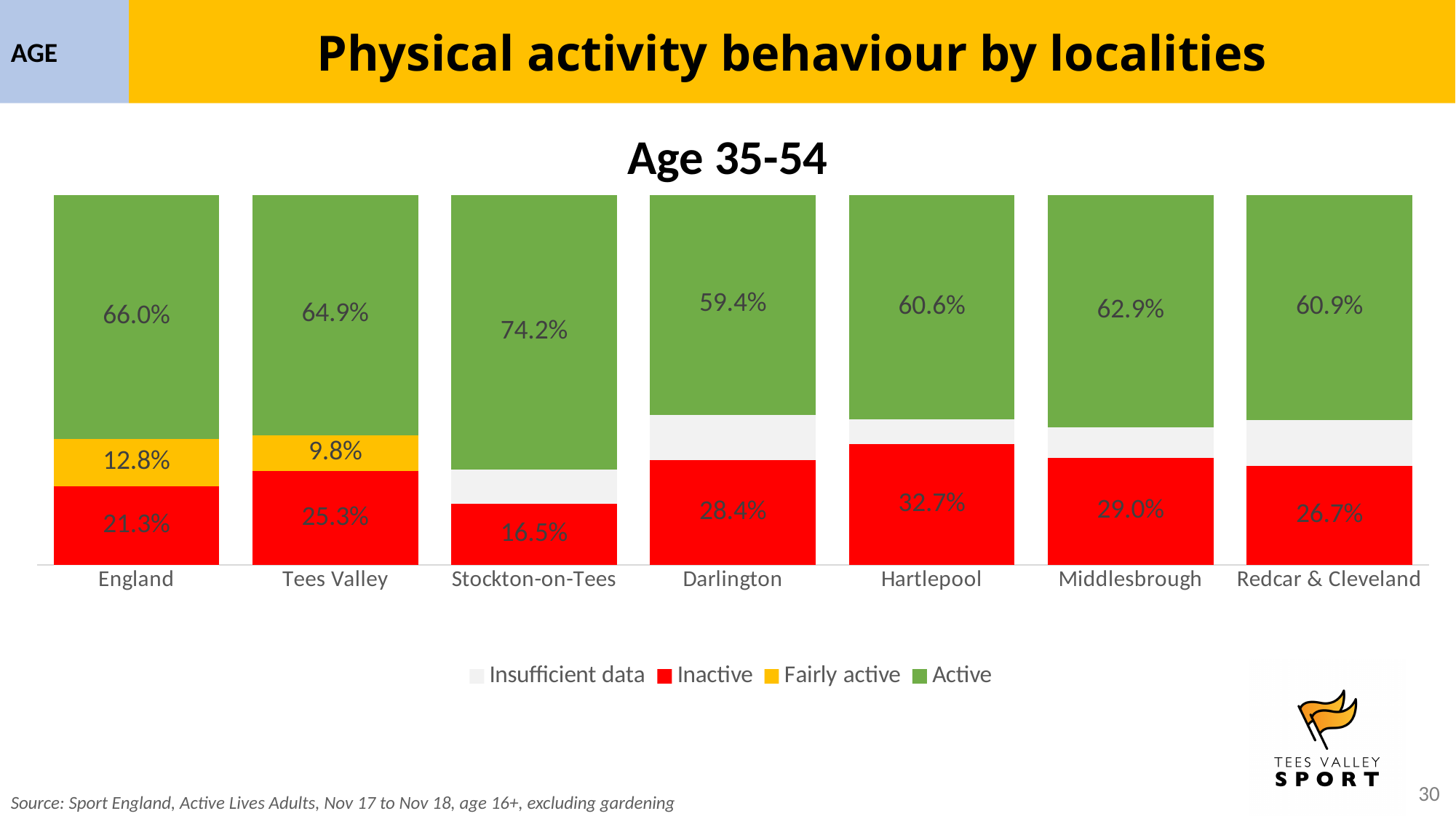
Which locality has the lowest Active value? Darlington What kind of chart is shown on the slide? Stacked bar chart What is the difference between the Inactive values for Hartlepool and England? 11.4% Which locality has the lowest Inactive value? Stockton-on-Tees Which has a higher Active value, Middlesbrough or Redcar & Cleveland? Middlesbrough What is the Active value for Stockton-on-Tees? 74.2% How many localities are shown on the x axis? 7 What is the Inactive value for Hartlepool? 32.7% How many series does the legend list? 4 Which locality has the highest Active value? Stockton-on-Tees Which colour represents the Inactive series? Red What is the Fairly active value for England? 12.8%